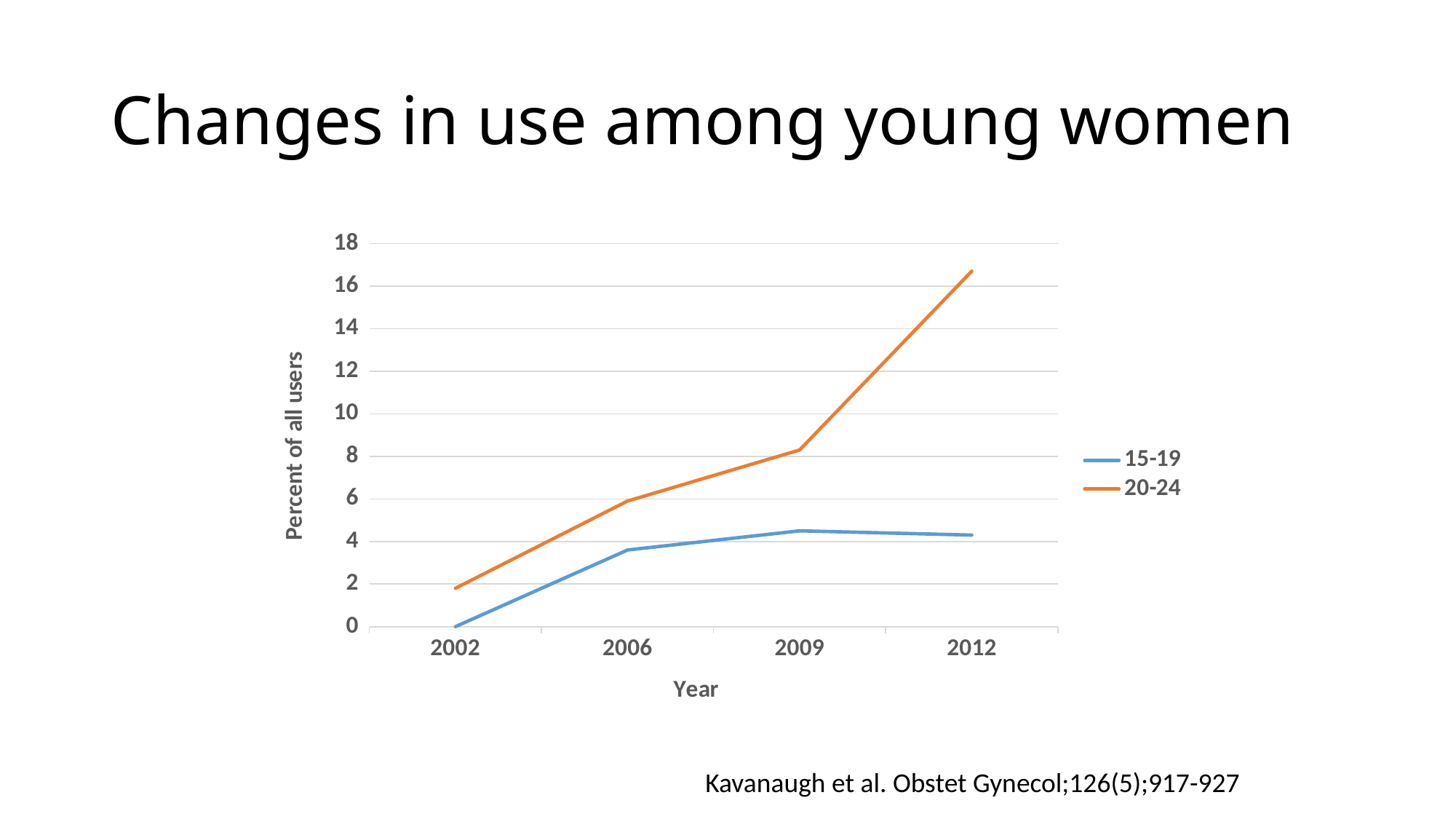
Does the 20-24 series rise or fall from 2002 to 2012? rise Which series has the higher value in 2012, 15-19 or 20-24? 20-24 Is the value for the 20-24 series in 2006 greater or less than 4? greater Is the value for the 15-19 series in 2009 greater or less than 6? less In which year is the 15-19 series at its lowest value? 2002 What is the value for the 15-19 series in 2002? 0 Is the value for the 20-24 series in 2012 greater or less than 16? greater In which year does the 20-24 series reach its highest value? 2012 What is the label on the vertical axis? Percent of all users What kind of chart is shown on the slide? line chart How many years are plotted along the x axis? 4 How many series does the legend list? 2